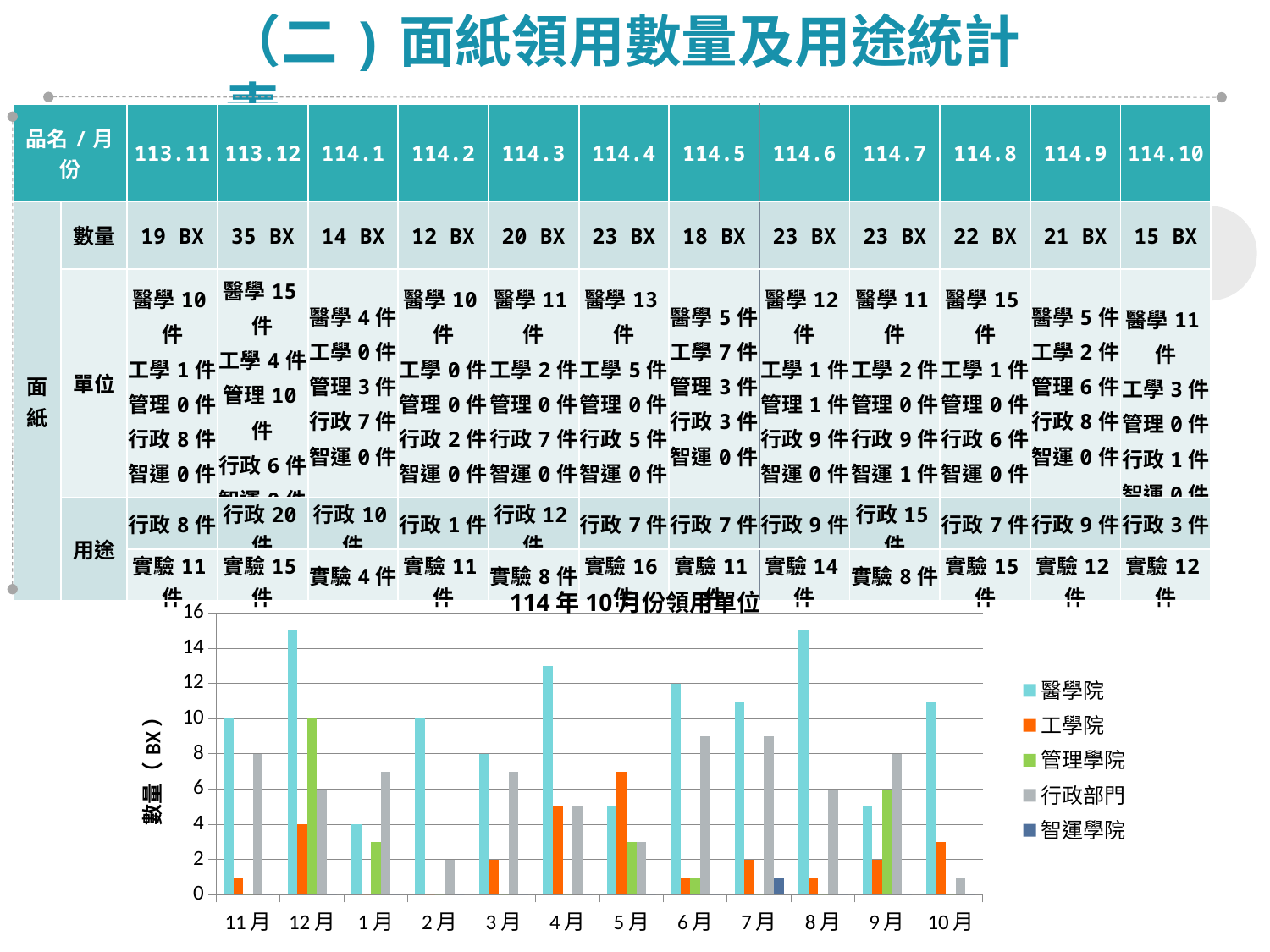
In the bar chart, what is the value for 管理學院 in 12月? 10 In the bar chart, which is larger in 5月: 工學院 or 醫學院? 工學院 In the bar chart, what is the value for 行政部門 in 11月? 8 In the bar chart, which series has the lowest non-zero value in 7月? 智運學院 In the bar chart, what is the value for 醫學院 in 2月? 10 How many series does the legend of the bar chart list? 5 In the bar chart, which series has the highest value in 12月? 醫學院 In the bar chart, is the value for 醫學院 in 4月 greater or less than 10? greater What is the y-axis label of the bar chart? 數量（BX） How many months are shown on the x axis of the bar chart? 12 What kind of chart is shown at the bottom of the slide? bar chart In the bar chart, what is the difference between 醫學院 and 行政部門 in 2月? 8